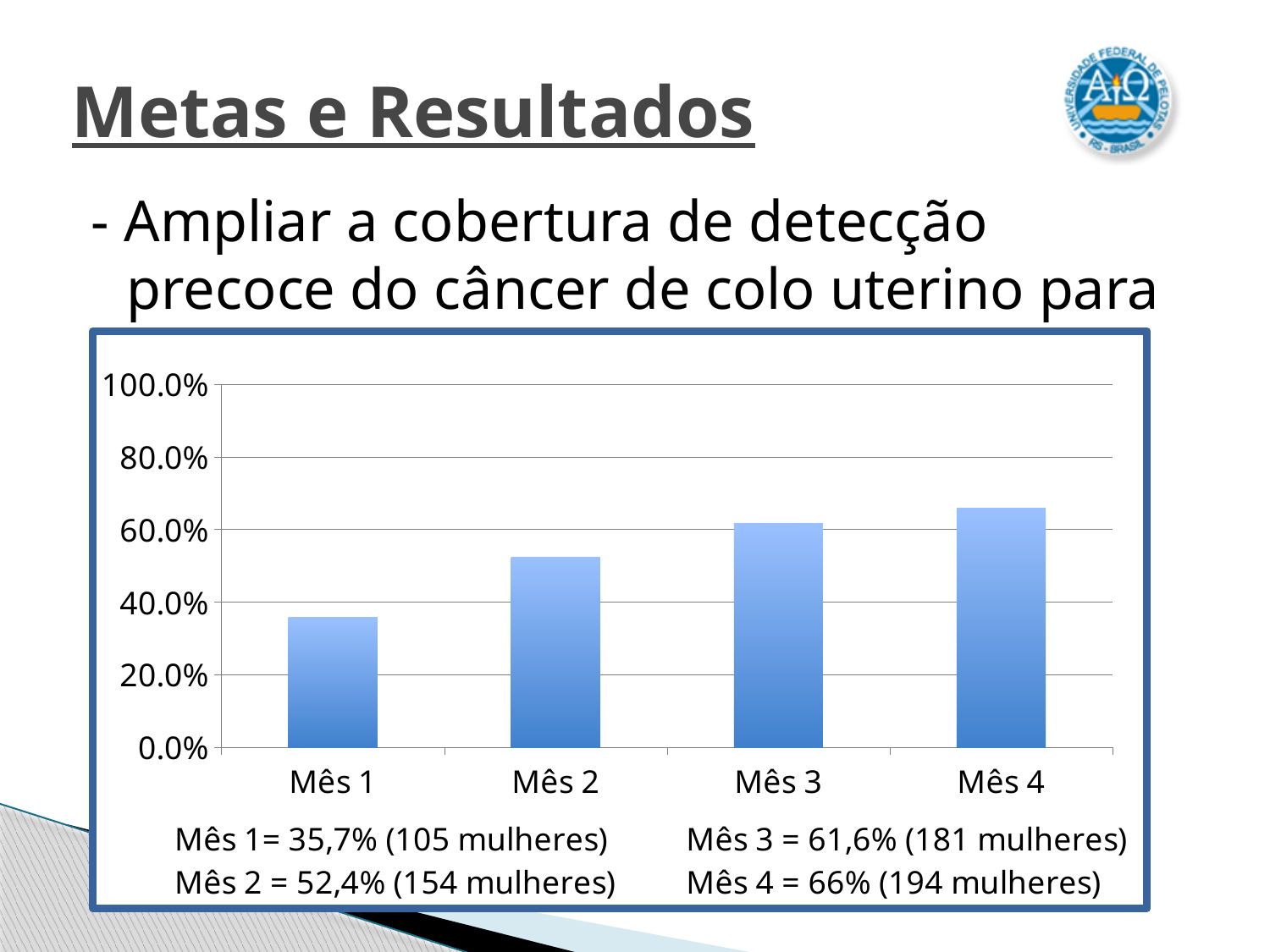
Which is larger, the value for Mês 2 or the value for Mês 3? Mês 3 Do the values rise or fall from Mês 1 to Mês 4? Rise How many women (mulheres) does the slide report for Mês 3? 181 mulheres What is the value for Mês 1? 35,7% What is the difference between the values for Mês 4 and Mês 3? 4,4 percentage points Which month has the highest value? Mês 4 What is the difference between the values for Mês 2 and Mês 1? 16,7 percentage points Is the value for Mês 1 greater or less than 40.0%? less Which month has the lowest value? Mês 1 What kind of chart is shown on the slide? Bar chart What is the value for Mês 4? 66% How many months (categories) are shown on the x axis? 4